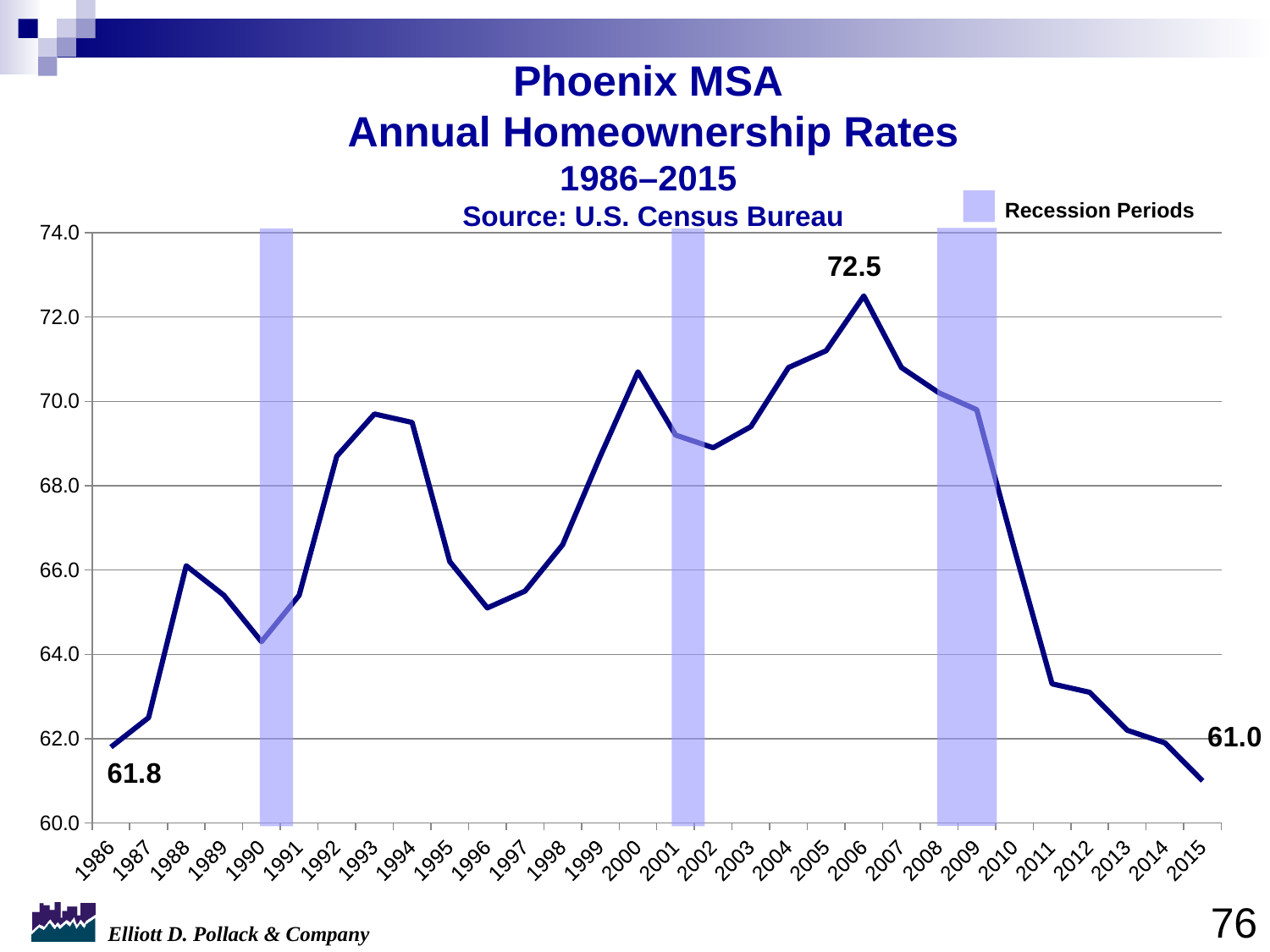
Is the value for 1990 greater or less than 66.0? less How many years are plotted on the x axis? 30 What is the homeownership rate shown for 2015? 61.0 In which year does the homeownership rate reach its highest point? 2006 Which year has the higher homeownership rate, 1986 or 2015? 1986 By how much did the rate fall from 2006 to 2015? 11.5 What kind of chart is shown on the slide? Line chart What is the difference between the 2006 rate and the 1986 rate? 10.7 What is the homeownership rate shown for 1986? 61.8 In which year is the homeownership rate at its lowest? 2015 Is the value for 2000 greater or less than 70.0? greater What is the homeownership rate shown for 2006? 72.5